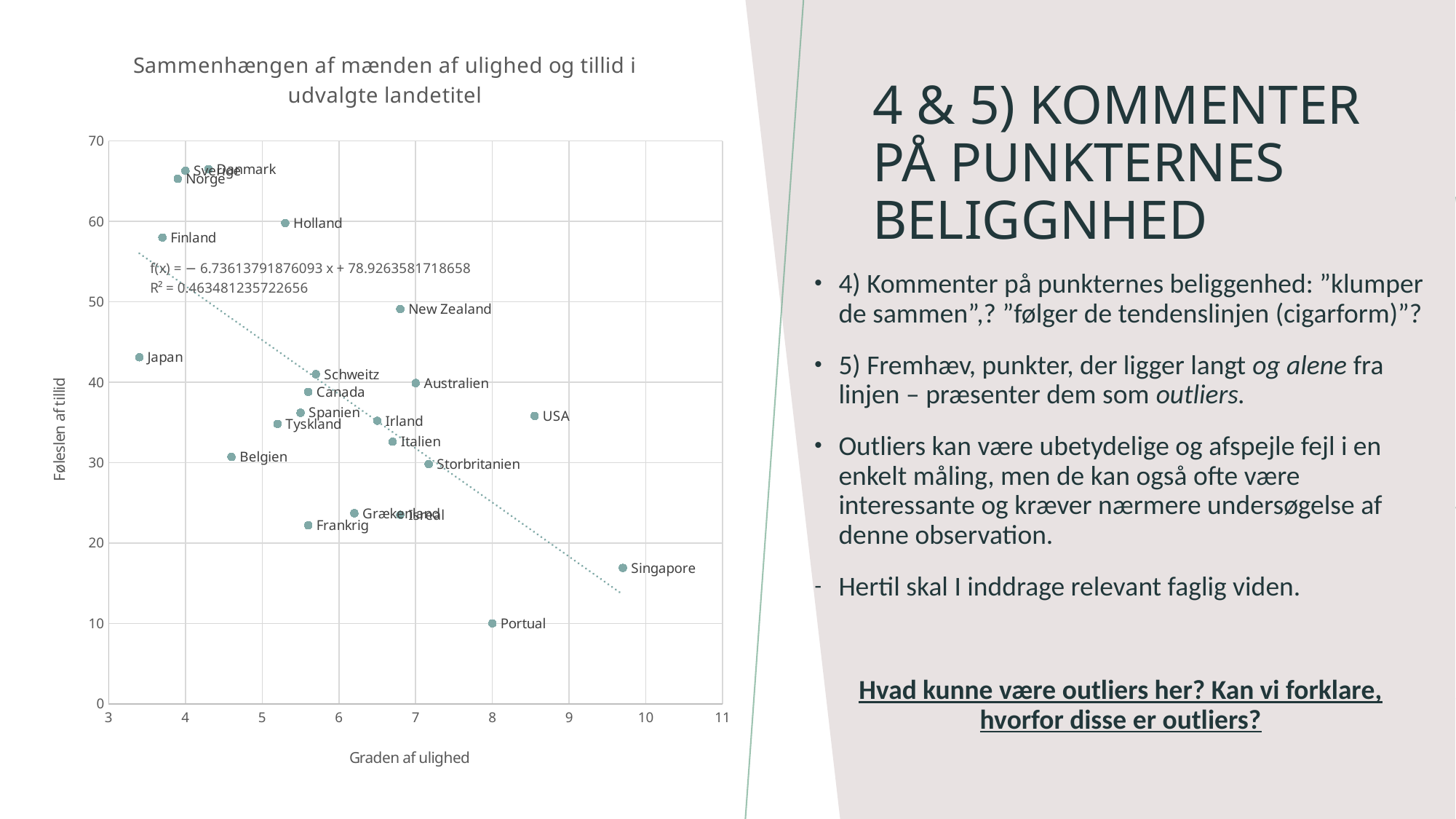
Which country has the lowest value on the vertical axis (Føleslen af tillid)? Portual What kind of chart is shown on the slide? scatter chart Which has the larger horizontal-axis value, USA or Singapore? Singapore Which country has the highest value on the horizontal axis (Graden af ulighed)? Singapore Is the vertical-axis value for Singapore greater or less than 20? less Is the vertical-axis value for Finland greater or less than 60? less Do the points generally rise or fall as the horizontal-axis value increases? fall Which has the higher vertical-axis value, Japan or Belgien? Japan Is the horizontal-axis value for USA greater or less than 8? greater Which country has the lowest value on the horizontal axis (Graden af ulighed)? Japan What R² value is printed on the chart? R² = 0.463481235722656